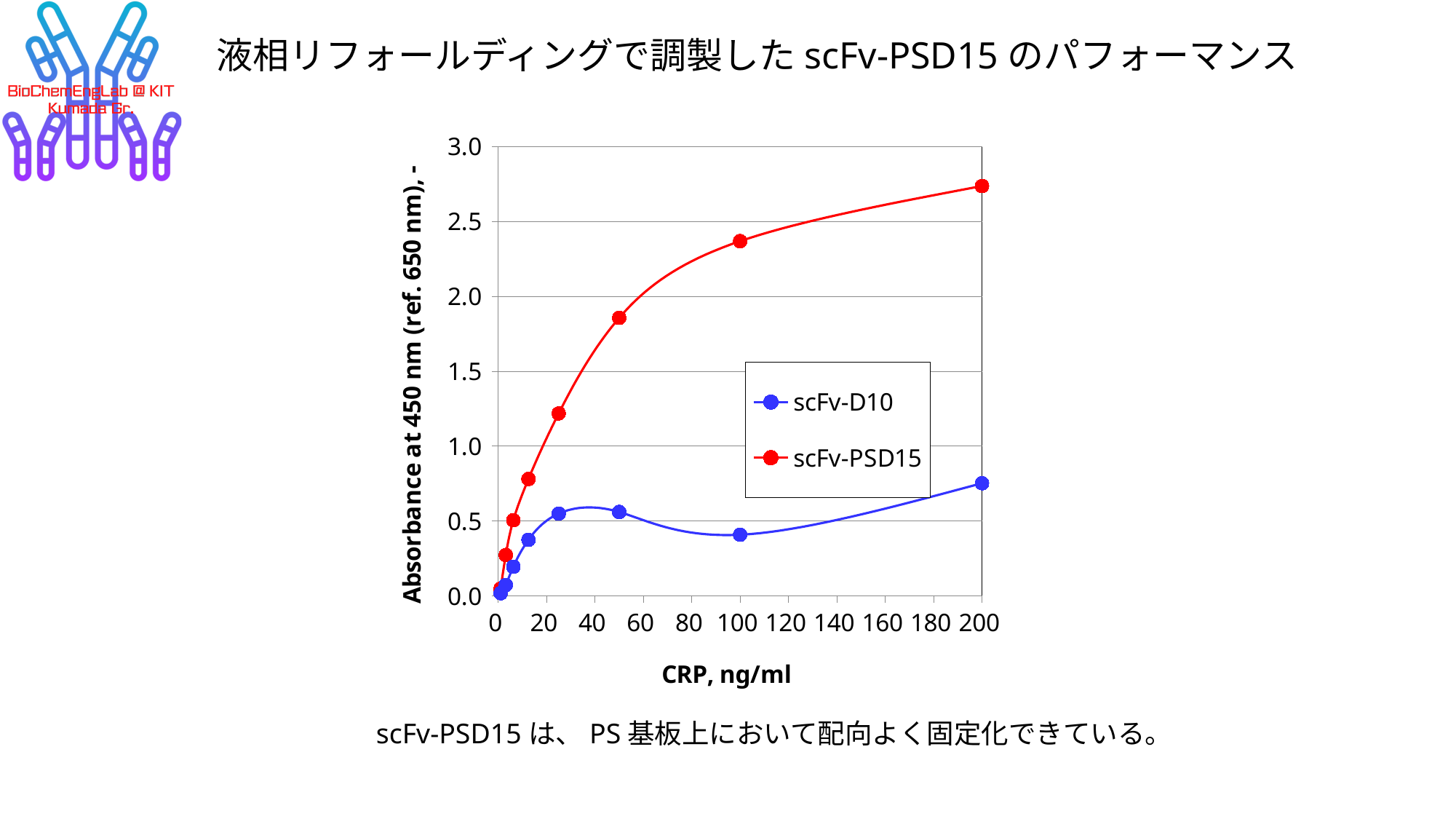
Which series has the higher absorbance at 200 ng/ml CRP? scFv-PSD15 How many series does the legend list? 2 Is the absorbance for scFv-PSD15 at 50 ng/ml CRP greater or less than 1.5? greater What is the label of the x axis? CRP, ng/ml Is the absorbance for scFv-PSD15 at 100 ng/ml CRP greater or less than 2.0? greater Is the absorbance for scFv-D10 at 200 ng/ml CRP greater or less than 1.0? less Which series has the higher absorbance at 50 ng/ml CRP? scFv-PSD15 What kind of chart is shown on the slide? line chart Does the absorbance for scFv-PSD15 rise or fall as CRP concentration increases? rise Which colour is used for the scFv-D10 series? blue